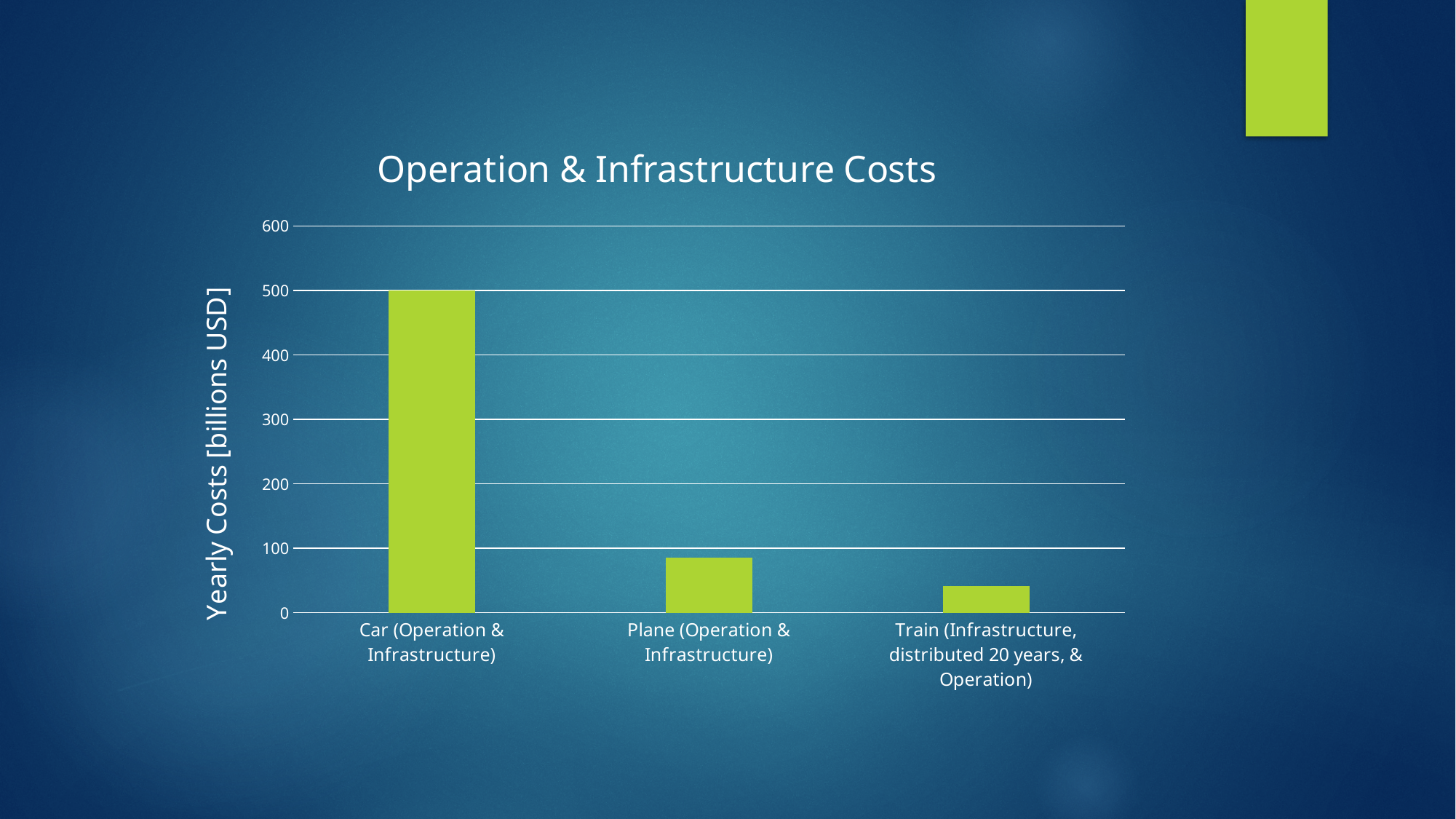
Which is larger, the value for Plane (Operation & Infrastructure) or the value for Train (Infrastructure, distributed 20 years, & Operation)? Plane (Operation & Infrastructure) Is the value for Car (Operation & Infrastructure) greater or less than 400? greater Is the value for Plane (Operation & Infrastructure) greater or less than 100? less Do the values rise or fall from left to right across the categories? fall Which category has the lowest yearly cost? Train (Infrastructure, distributed 20 years, & Operation) How many categories are plotted in the chart? 3 What type of chart is shown on the slide? bar chart Is the value for Train (Infrastructure, distributed 20 years, & Operation) greater or less than 100? less What is the yearly cost for Car (Operation & Infrastructure) in billions USD? 500 What is the title of the chart? Operation & Infrastructure Costs Which category has the highest yearly cost? Car (Operation & Infrastructure) What is the label of the vertical axis? Yearly Costs [billions USD]